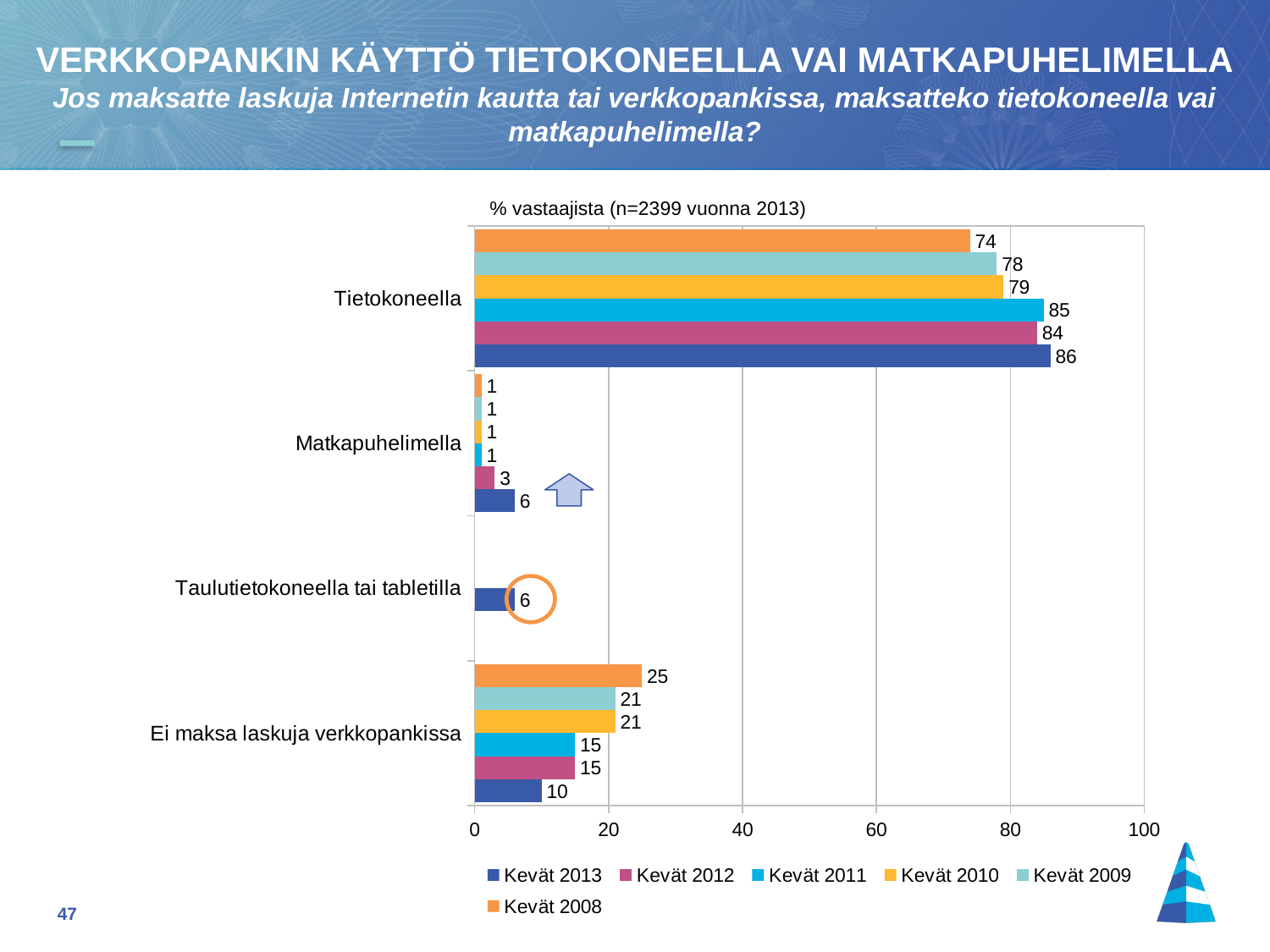
How many series does the legend list? 6 What kind of chart is shown on the slide? Bar chart What is the difference between the Kevät 2008 and Kevät 2013 values for Ei maksa laskuja verkkopankissa? 15 How many categories are shown on the vertical axis? 4 Which is larger for Tietokoneella: the Kevät 2011 value or the Kevät 2010 value? Kevät 2011 Which year has the lowest value for Tietokoneella? Kevät 2008 What is the text shown above the chart describing the unit of the values? % vastaajista (n=2399 vuonna 2013) What is the value for Ei maksa laskuja verkkopankissa in Kevät 2008? 25 What is the value for Tietokoneella in Kevät 2013? 86 What is the value for Taulutietokoneella tai tabletilla in Kevät 2013? 6 Which category has the highest value in Kevät 2013? Tietokoneella What is the value for Matkapuhelimella in Kevät 2012? 3